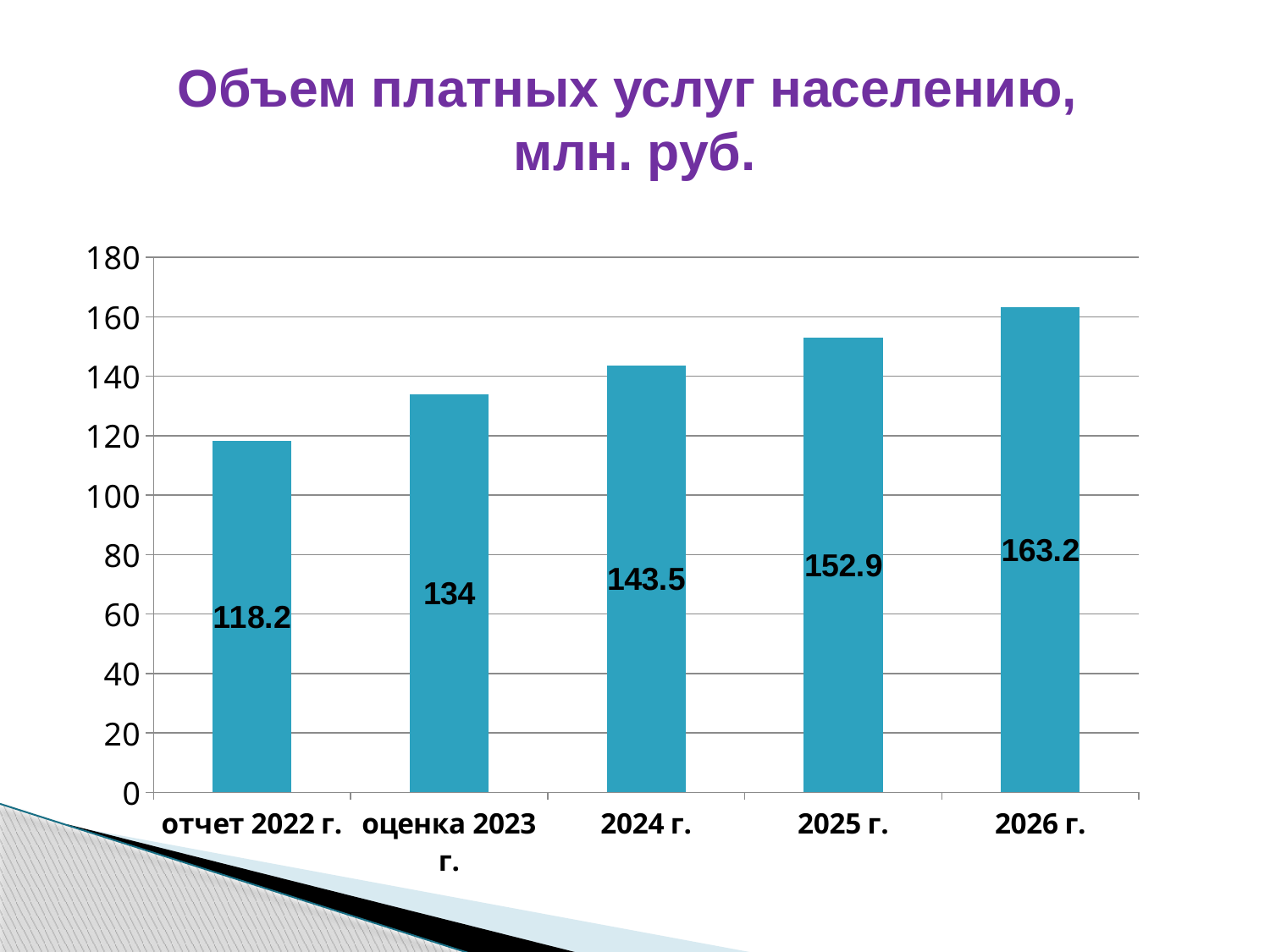
Which category has the highest value? 2026 г. Which category has the lowest value? отчет 2022 г. Is the value for 2026 г. greater or less than 160? greater What is the value for 2025 г.? 152.9 Do the values rise or fall from отчет 2022 г. to 2026 г.? rise What is the value for отчет 2022 г.? 118.2 What is the value for оценка 2023 г.? 134 What is the difference between the values for 2026 г. and отчет 2022 г.? 45 What kind of chart is shown on the slide? bar chart What is the difference between the values for 2024 г. and оценка 2023 г.? 9.5 Which is larger, the value for 2024 г. or the value for 2025 г.? 2025 г. How many categories are shown on the x axis? 5